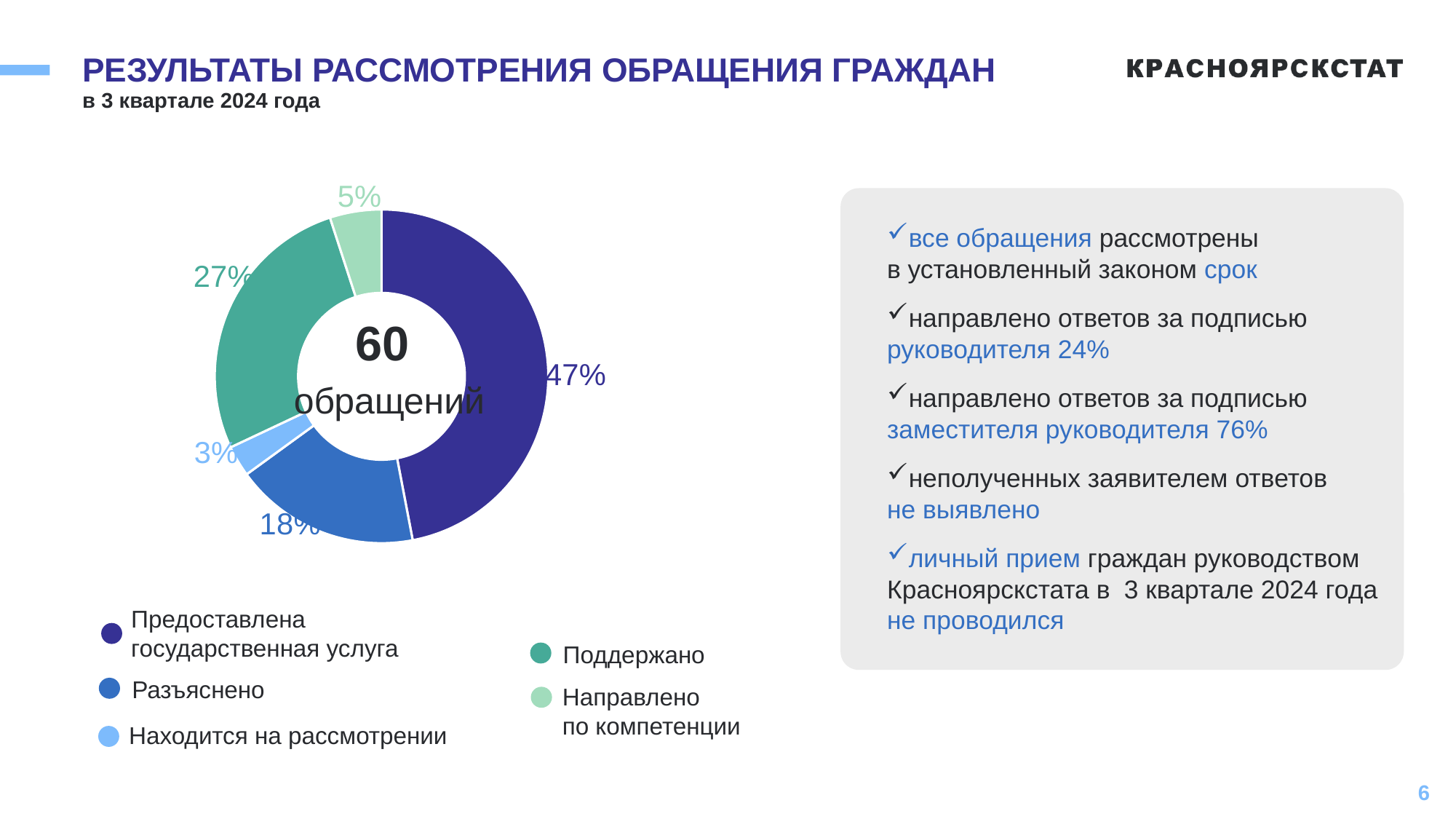
What percentage does the "Разъяснено" slice show? 18% What percentage is shown for "Находится на рассмотрении"? 3% What is the difference in percentage points between "Предоставлена государственная услуга" and "Поддержано"? 20 What type of chart is shown on the slide? Pie chart (donut) How many slices does the pie chart have? 5 Which category has the largest share of the pie chart? Предоставлена государственная услуга Which category has the smallest share of the pie chart? Находится на рассмотрении What percentage does the "Поддержано" slice show? 27% What percentage is shown for "Направлено по компетенции"? 5% Which is larger: the share for "Разъяснено" or the share for "Поддержано"? Поддержано What number is shown in the centre of the donut chart? 60 обращений What share of the pie chart is labelled "Предоставлена государственная услуга"? 47%